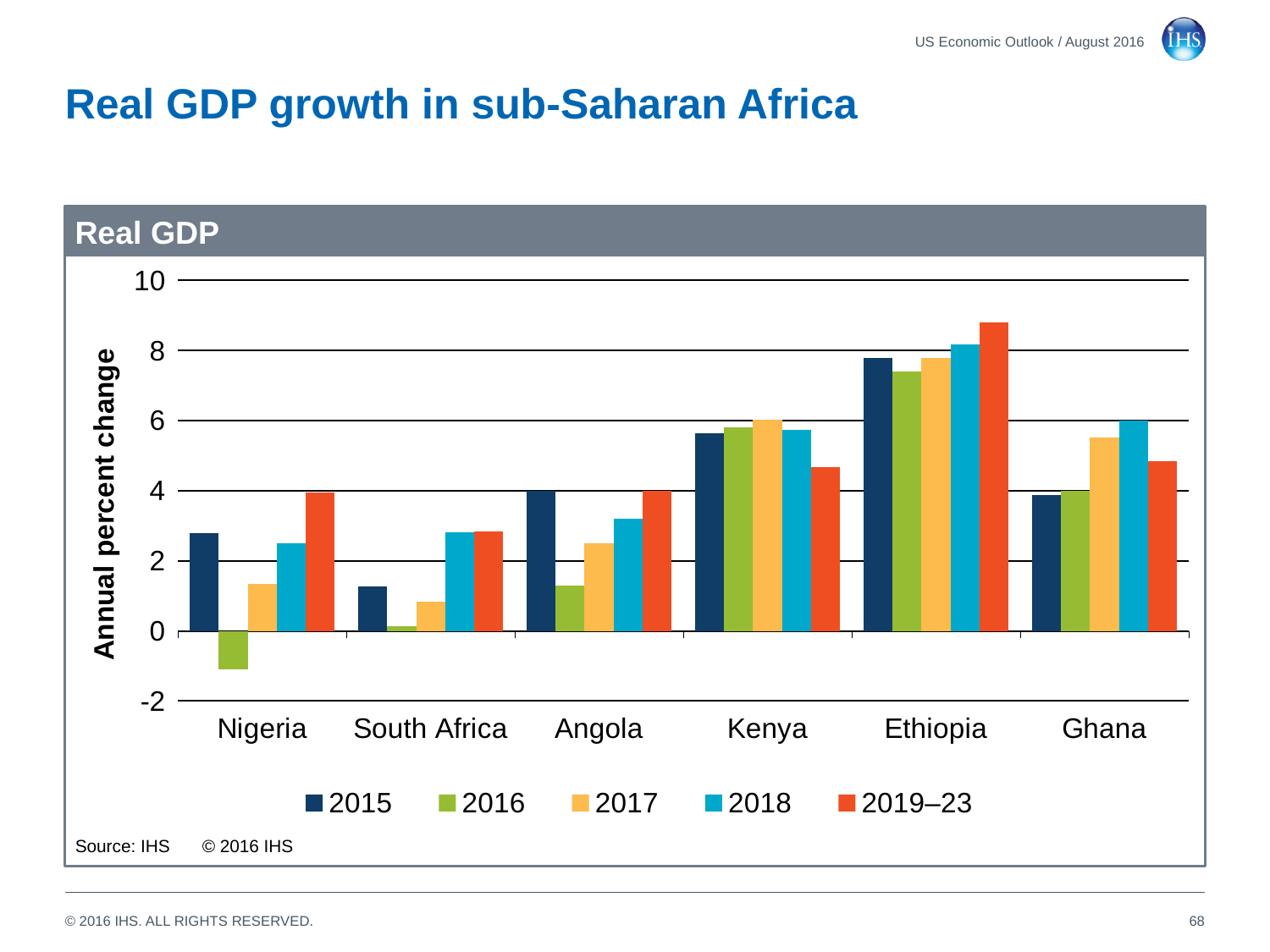
Which country has the highest value for the 2019–23 series? Ethiopia Which is larger, the 2017 value for Kenya or the 2017 value for Ghana? Kenya Which country has the highest value for the 2015 series? Ethiopia Which country has the lowest value for the 2016 series? Nigeria How many series does the chart's legend list? 5 How many countries are shown on the x axis of the chart? 6 What is the title shown in the chart's header bar? Real GDP Is the 2015 value for South Africa greater or less than 2? less What is the label on the vertical axis of the chart? Annual percent change Is the 2016 value for Nigeria greater or less than 0? less What kind of chart is shown on the slide? Bar chart Is the 2018 value for Ethiopia greater or less than 8? greater